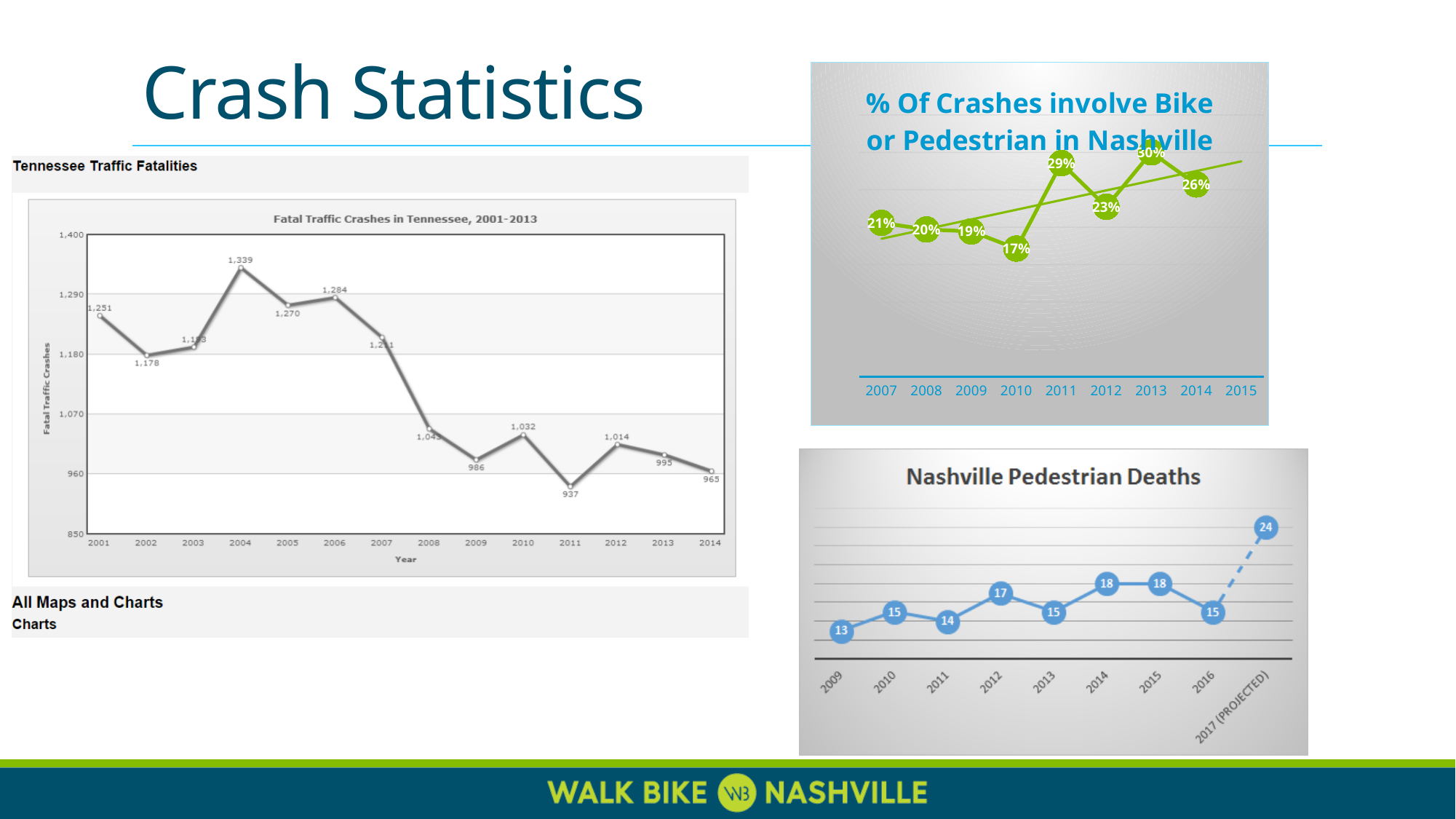
In the Fatal Traffic Crashes in Tennessee chart, what is the difference between the 2001 value and the 2014 value? 286 In the % Of Crashes involve Bike or Pedestrian in Nashville chart, what is the value for 2010? 17% In the Fatal Traffic Crashes in Tennessee chart, is the value for 2009 greater or less than 1,070? less In the Nashville Pedestrian Deaths chart, what is the value for 2012? 17 In the Nashville Pedestrian Deaths chart, how many data points are plotted? 9 In the % Of Crashes involve Bike or Pedestrian in Nashville chart, which year has the lowest percentage? 2010 In the Fatal Traffic Crashes in Tennessee chart, which year had the lowest number of fatal crashes? 2011 In the Fatal Traffic Crashes in Tennessee chart, what was the value for 2004? 1,339 In the Nashville Pedestrian Deaths chart, which year has the highest value? 2017 (Projected) In the % Of Crashes involve Bike or Pedestrian in Nashville chart, which is larger, the value for 2011 or the value for 2012? 2011 In the Nashville Pedestrian Deaths chart, what is the difference between the 2017 (Projected) value and the 2016 value? 9 In the Fatal Traffic Crashes in Tennessee chart, what kind of chart is shown? Line chart